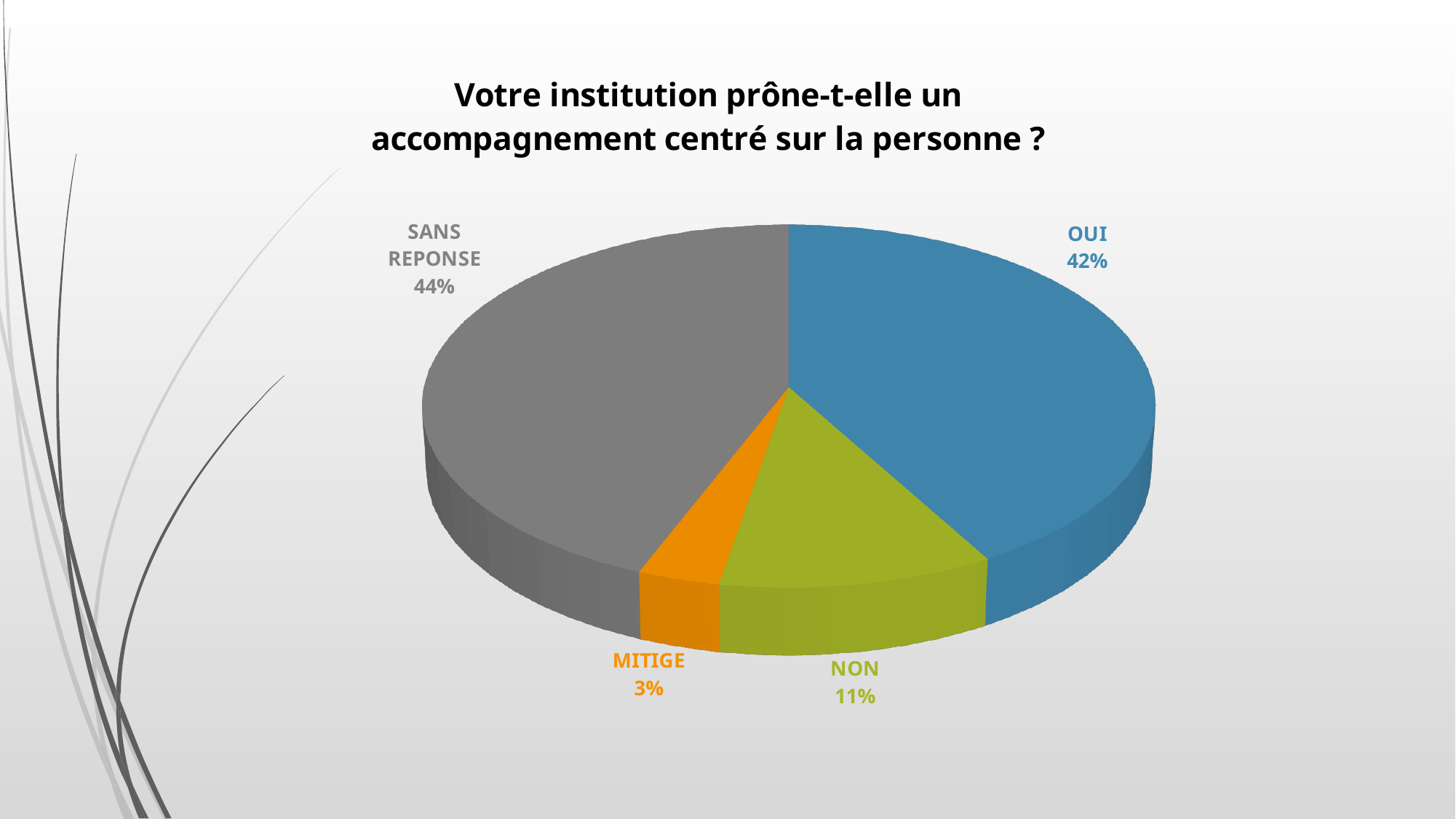
Which category has the smallest slice of the pie? MITIGE What colour is the OUI slice? Blue What is the difference in percentage points between NON and MITIGE? 8% What is the value shown for MITIGE? 3% Which is larger, NON or MITIGE? NON What is the value shown for SANS REPONSE? 44% What is the value shown for NON? 11% Which category has the largest slice of the pie? SANS REPONSE What kind of chart is shown on the slide? Pie chart What share of the pie does OUI represent? 42% How many categories are shown in the pie chart? 4 What is the difference in percentage points between SANS REPONSE and OUI? 2%